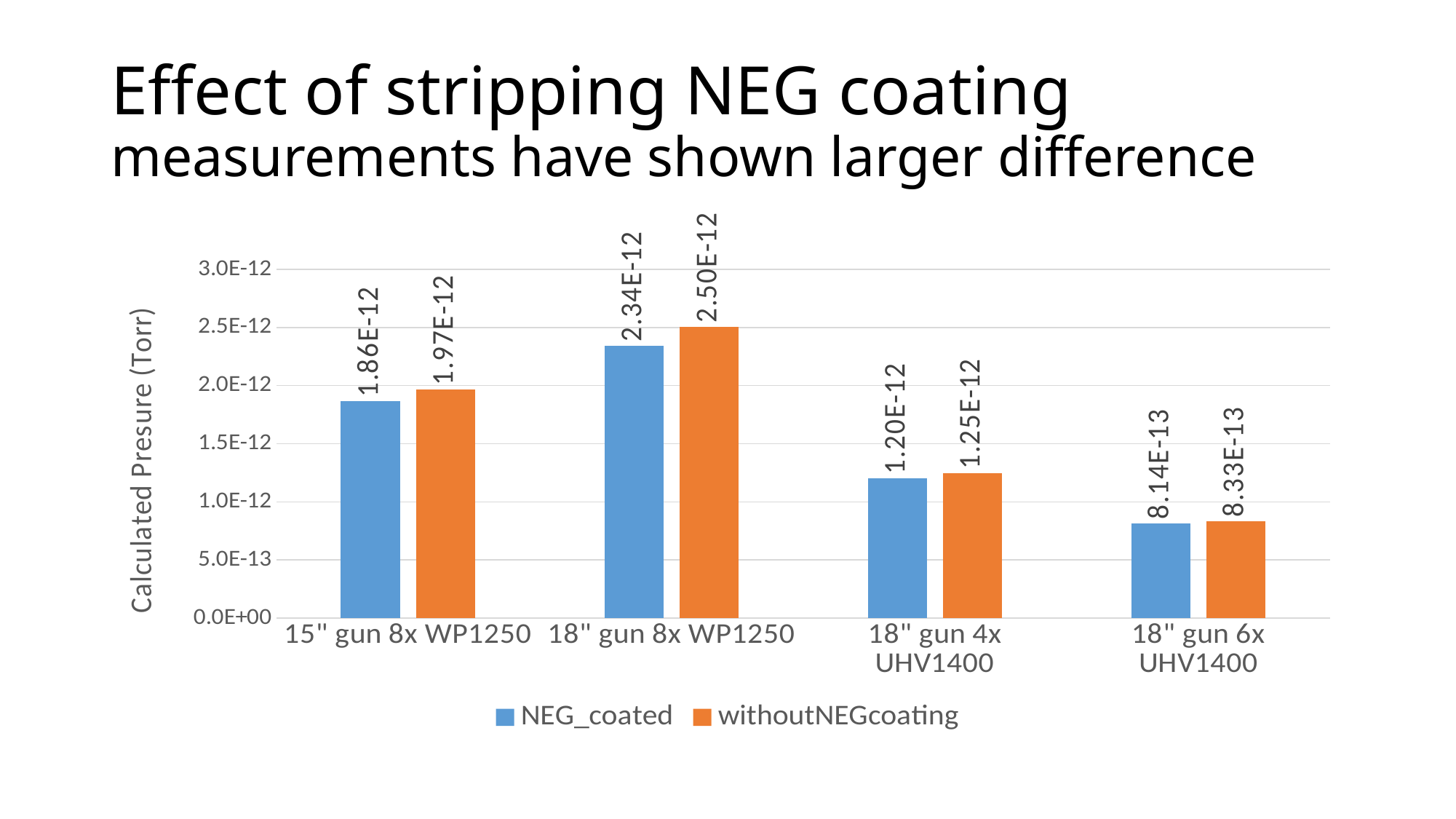
What is the withoutNEGcoating value for 18" gun 8x WP1250? 2.50E-12 Which category has the lowest NEG_coated value? 18" gun 6x UHV1400 What is the NEG_coated value for 18" gun 6x UHV1400? 8.14E-13 How many series does the legend list? 2 What is the withoutNEGcoating value for 18" gun 4x UHV1400? 1.25E-12 Which category has the highest withoutNEGcoating value? 18" gun 8x WP1250 What is the NEG_coated value for 15" gun 8x WP1250? 1.86E-12 For 18" gun 8x WP1250, which is larger: the NEG_coated value or the withoutNEGcoating value? withoutNEGcoating How many categories are shown on the x axis? 4 What kind of chart is shown on the slide? bar chart What is the difference between the withoutNEGcoating and NEG_coated values for 18" gun 8x WP1250? 1.60E-13 Is the NEG_coated value for 18" gun 8x WP1250 greater or less than 2.0E-12? greater